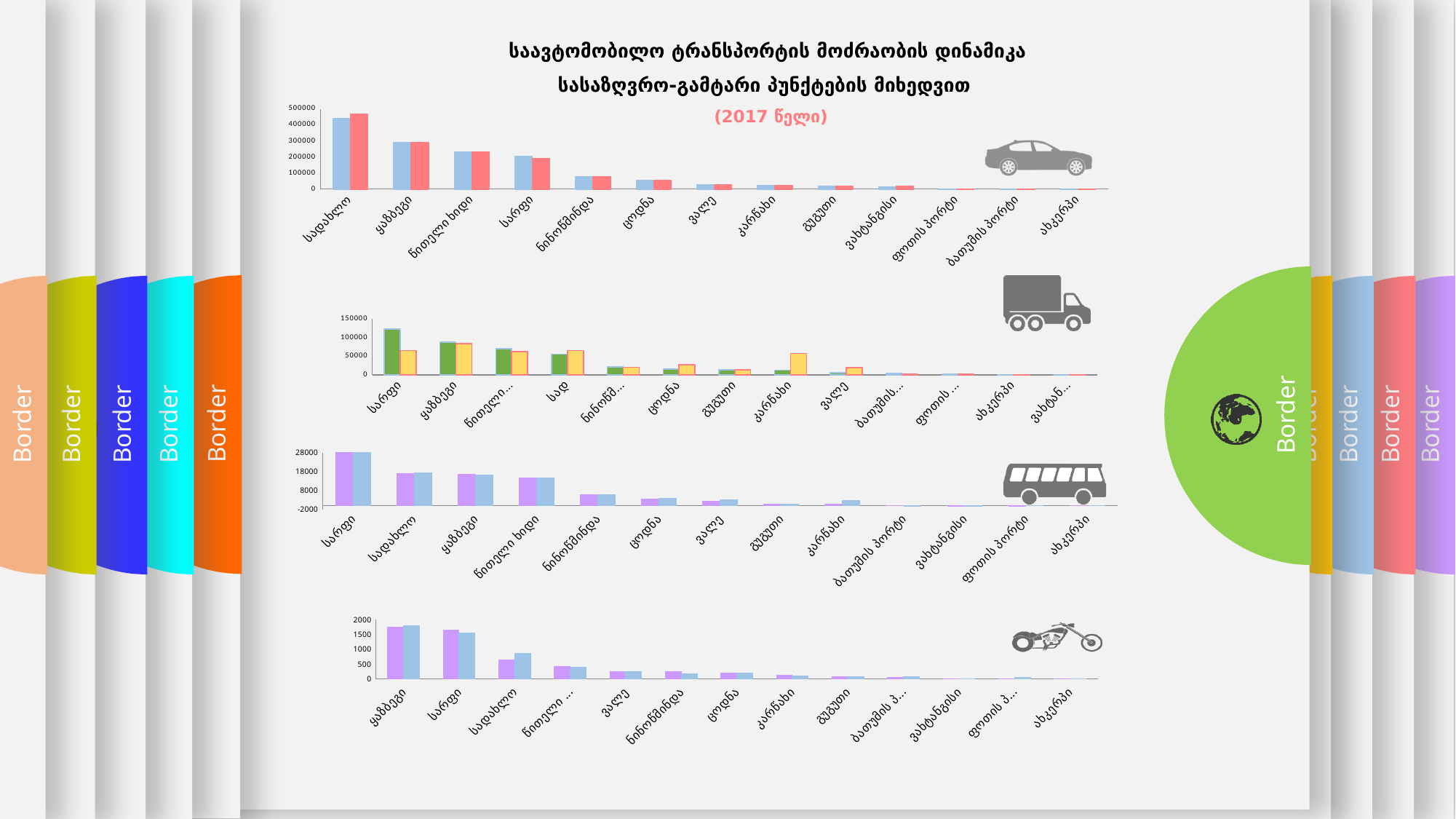
In the second chart from the top (with the truck icon), is the value of the green bar for სარფი greater or less than 100000? greater How many categories are shown on the x axis of the top chart (with the car icon)? 13 In the bottom chart (with the motorcycle icon), which category has larger values, სარფი or სადახლო? სარფი Which year is stated in the title of the slide? 2017 In the third chart from the top (with the bus icon), which category has the highest values? სარფი In the second chart from the top (with the truck icon), is the value of the yellow bar for ვალე greater or less than 50000? less What kind of chart is the top chart on the slide (with the car icon)? bar chart In the bottom chart (with the motorcycle icon), do the values generally rise or fall from left to right along the x axis? fall In the top chart (with the car icon), which category has the highest values? სადახლო In the top chart (with the car icon), which category has larger values, ყაზბეგი or სარფი? ყაზბეგი In the top chart (with the car icon), is the value of the blue bar for ყაზბეგი greater or less than 200000? greater